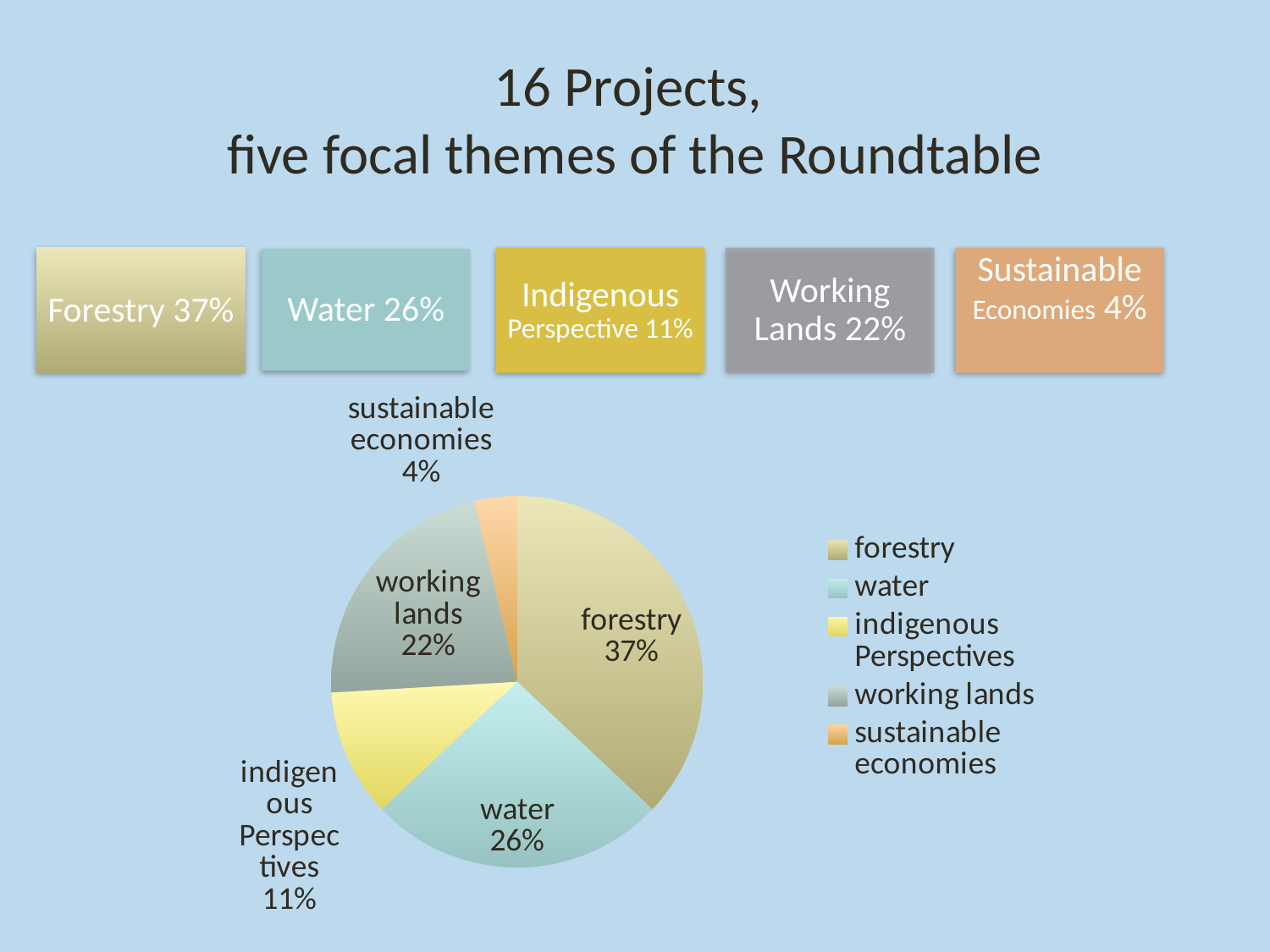
What share of the pie does forestry have? 37% Which is larger, the water slice or the working lands slice? water What is the difference in percentage points between forestry and water? 11 What share of the pie does working lands have? 22% What share of the pie does water have? 26% Which slice of the pie is the smallest? sustainable economies How many entries does the legend list? 5 How many slices does the pie chart have? 5 Which slice of the pie is the largest? forestry What kind of chart is shown on the slide? pie chart